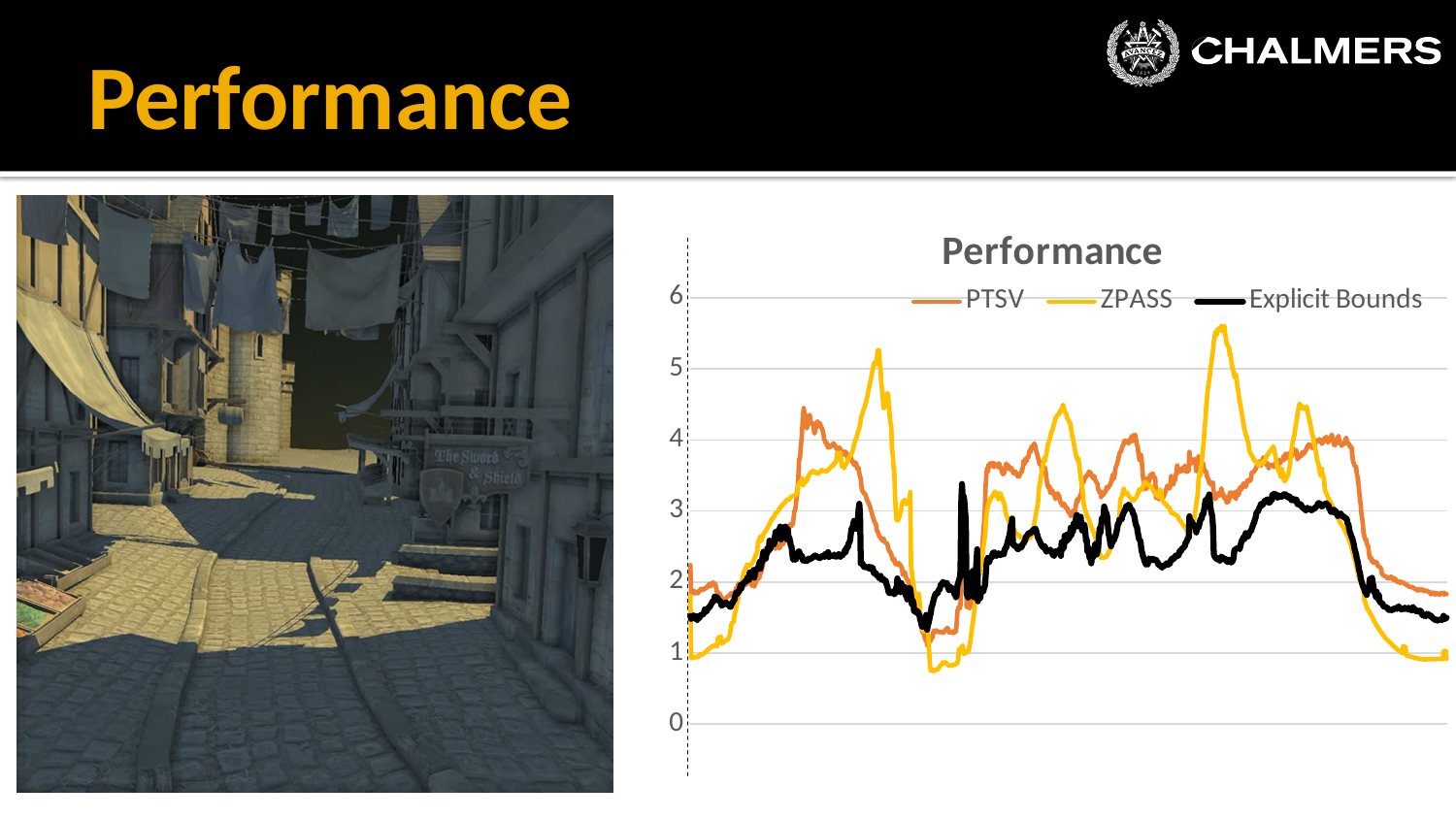
What is the title of the chart? Performance Is the highest value reached by ZPASS greater or less than 5? greater Which series reaches the highest peak value in the chart? ZPASS What kind of chart is shown on the slide? line chart Is the highest value reached by PTSV greater or less than 5? less Which series has the lowest peak value in the chart? Explicit Bounds Is the highest value reached by Explicit Bounds greater or less than 4? less How many series does the chart's legend list? 3 What is the highest tick value shown on the vertical axis of the chart? 6 Which series is drawn in black in the chart? Explicit Bounds Which series reaches a higher peak, PTSV or Explicit Bounds? PTSV